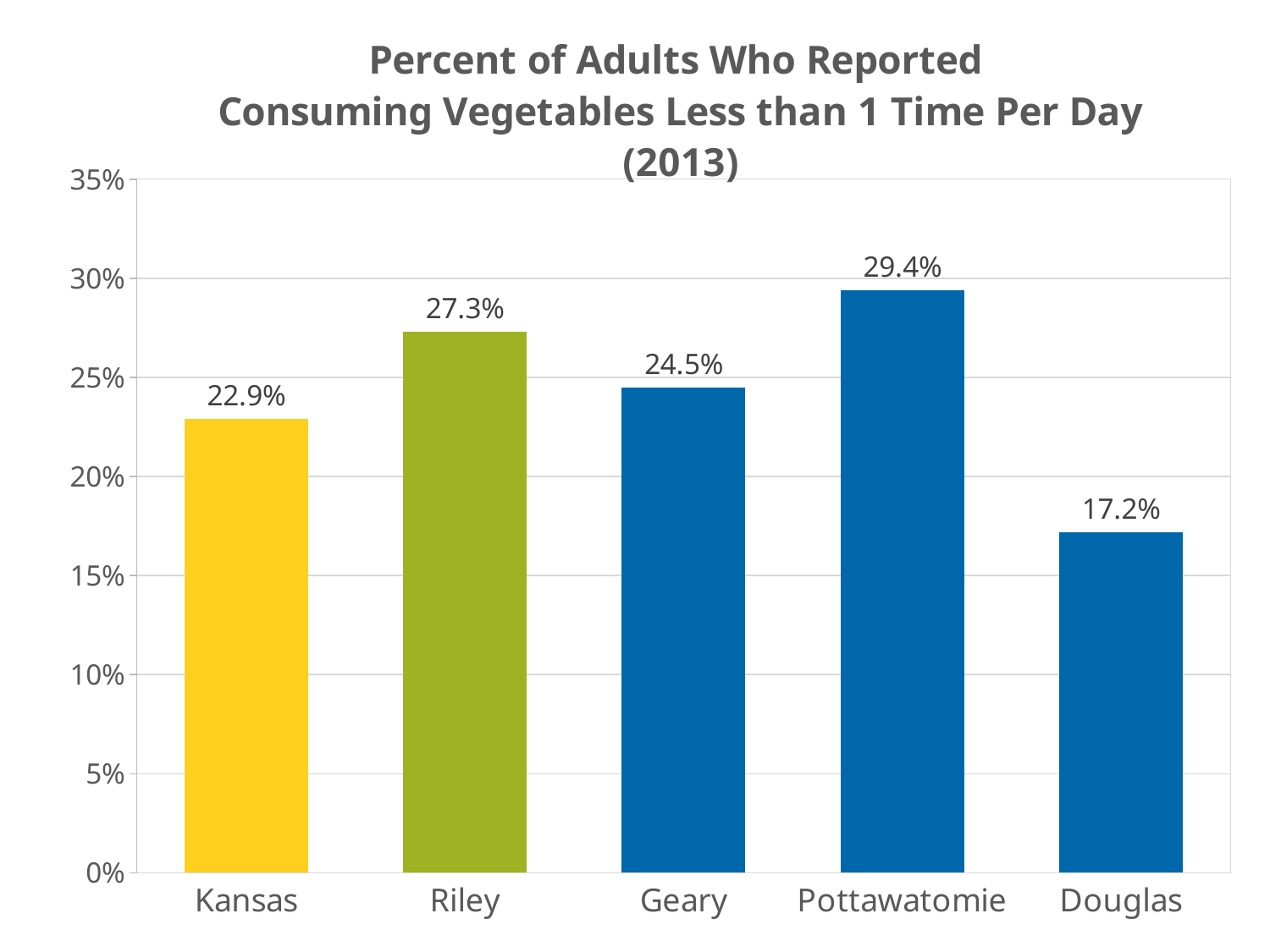
What is the value for Geary? 24.5% What kind of chart is shown on the slide? Bar chart What is the difference between the values for Riley and Kansas? 4.4% Which is larger, the value for Geary or the value for Kansas? Geary Is the value for Douglas greater or less than 20%? less What is the value for Douglas? 17.2% What is the value for Kansas? 22.9% How many categories are shown on the chart? 5 Which category has the highest value? Pottawatomie Which category has the lowest value? Douglas What is the difference between the values for Pottawatomie and Douglas? 12.2% What is the value for Riley? 27.3%